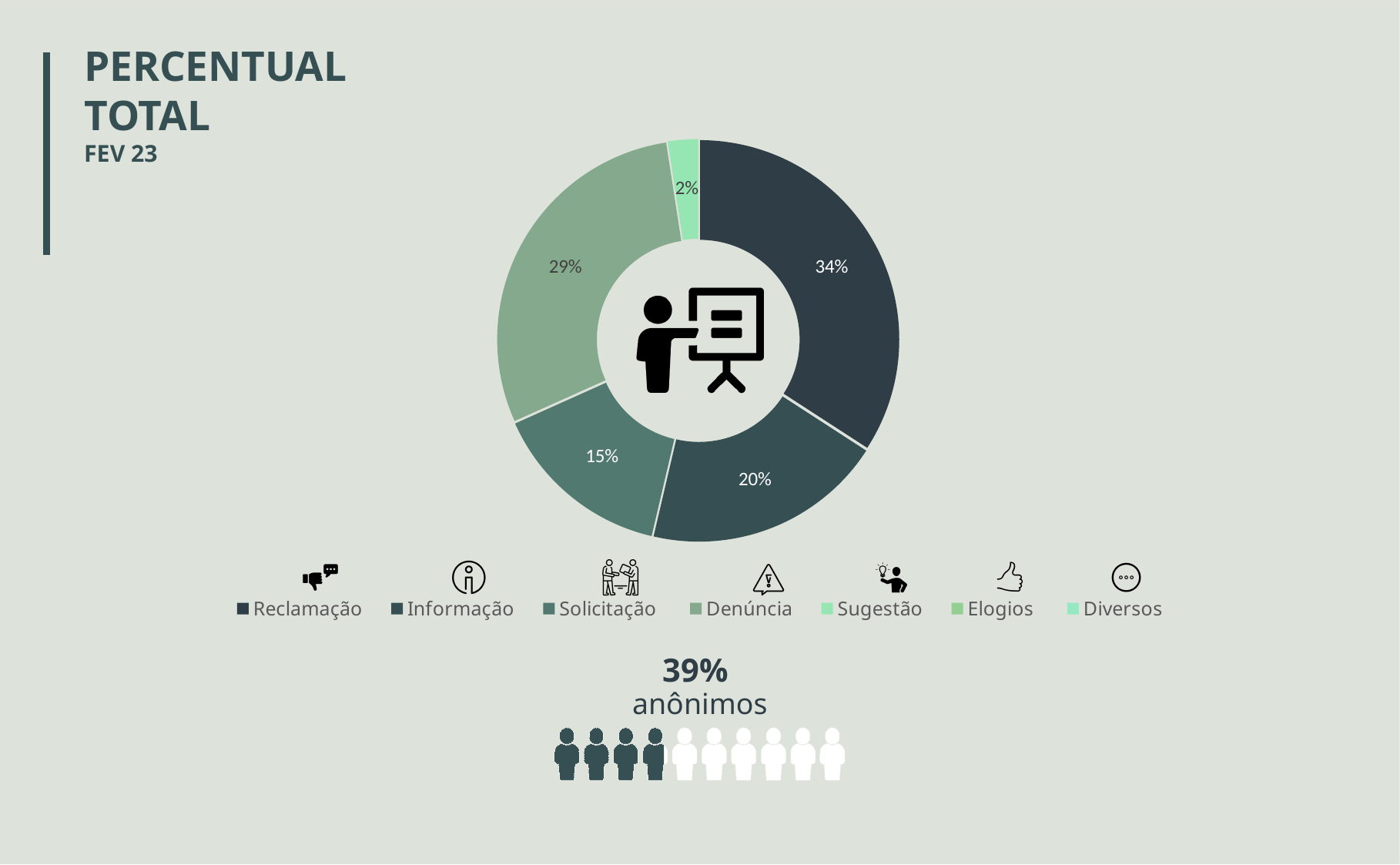
What percentage does the Solicitação slice show? 15% What percentage does the Reclamação slice show? 34% What is the smallest percentage labelled on the chart? 2% Which category has the largest slice of the chart? Reclamação How many categories does the legend list? 7 What kind of chart is shown on the slide? doughnut chart What is the title of the slide? PERCENTUAL TOTAL What percentage does the Denúncia slice show? 29% What percentage does the Informação slice show? 20% Which slice is larger, Informação or Solicitação? Informação How many slices have a percentage label on the chart? 5 By how many percentage points does Reclamação exceed Denúncia? 5 percentage points